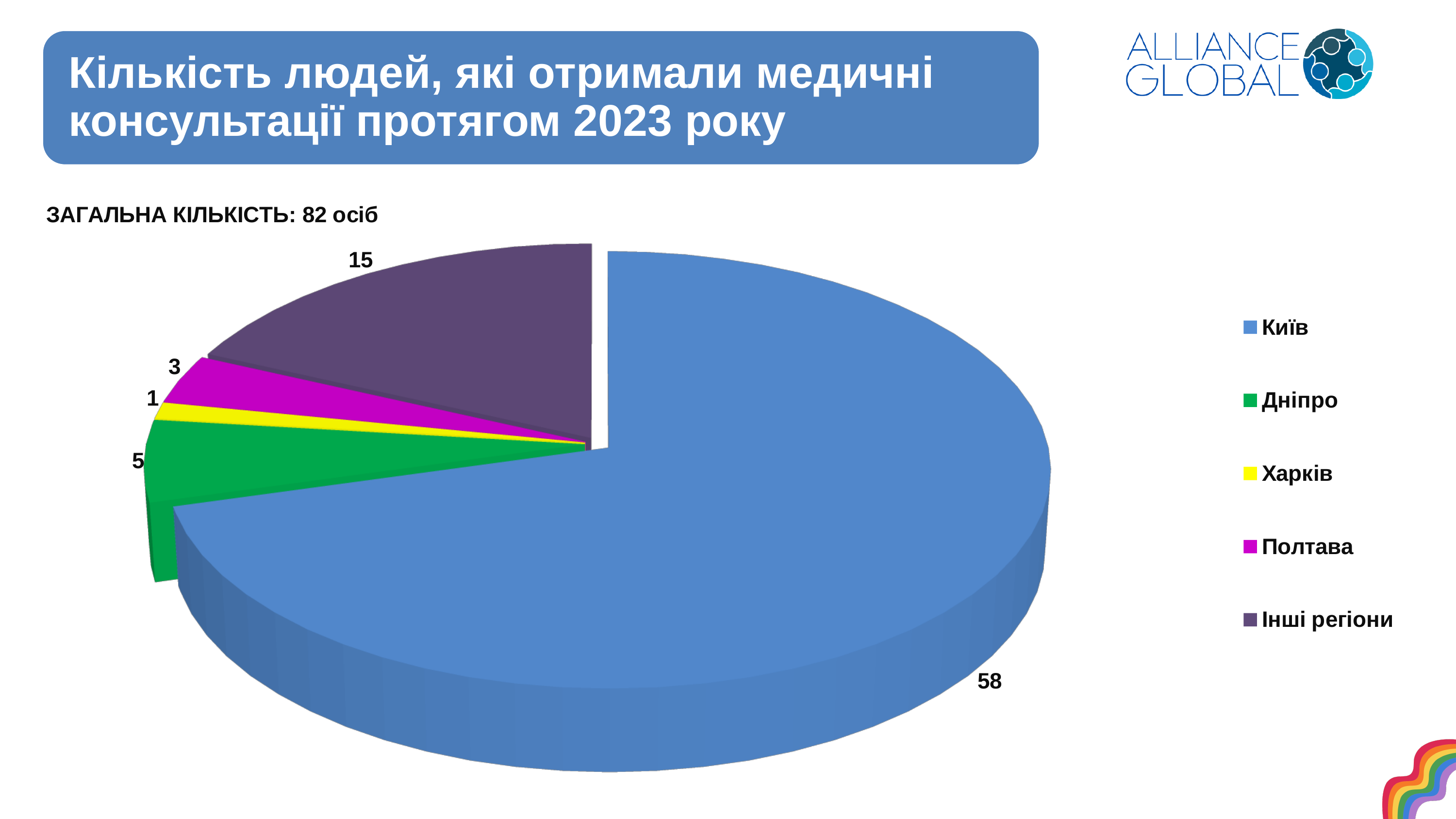
What is the value for Дніпро? 5 What is the value for Полтава? 3 What kind of chart is shown on the slide? pie chart How many categories does the legend list? 5 What is the value for Київ? 58 What is the value for Інші регіони? 15 What is the value for Харків? 1 Which is larger, the value for Дніпро or the value for Полтава? Дніпро Which category has the largest slice? Київ What is the difference between the values for Київ and Інші регіони? 43 What total number of people is stated above the chart? 82 осіб Which category has the smallest slice? Харків